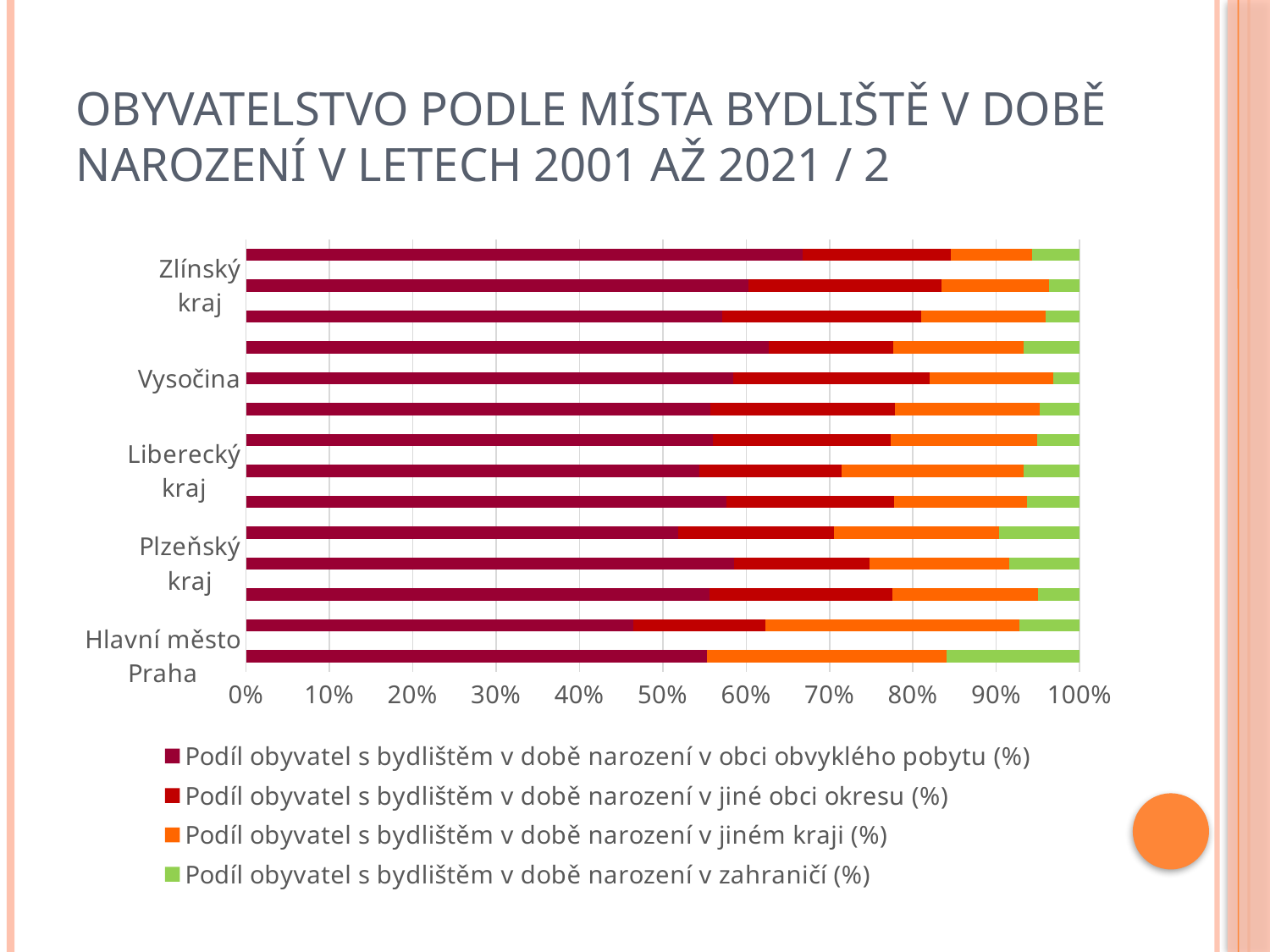
How many bars are plotted in the chart? 14 Among the labelled regions, which has the smallest share of residents born in another municipality of the district (second segment)? Hlavní město Praha Is the share of residents born in the municipality of usual residence (first segment) for Hlavní město Praha greater or less than 60%? less Is the share of residents born in the municipality of usual residence (first segment) for Vysočina greater or less than 50%? greater What is the highest value shown on the horizontal axis? 100% Which colour represents 'Podíl obyvatel s bydlištěm v době narození v zahraničí (%)' in the legend? Green Is the share of residents born in the municipality of usual residence (first segment) for Liberecký kraj greater or less than 70%? less How many series does the legend list? 4 What kind of chart is shown on the slide? Stacked bar chart Among the labelled regions, which has the largest share of residents born abroad (green segment)? Hlavní město Praha Which has the larger share of residents born in another region (orange segment): Hlavní město Praha or Vysočina? Hlavní město Praha Which has the larger share of residents born abroad (green segment): Plzeňský kraj or Vysočina? Plzeňský kraj